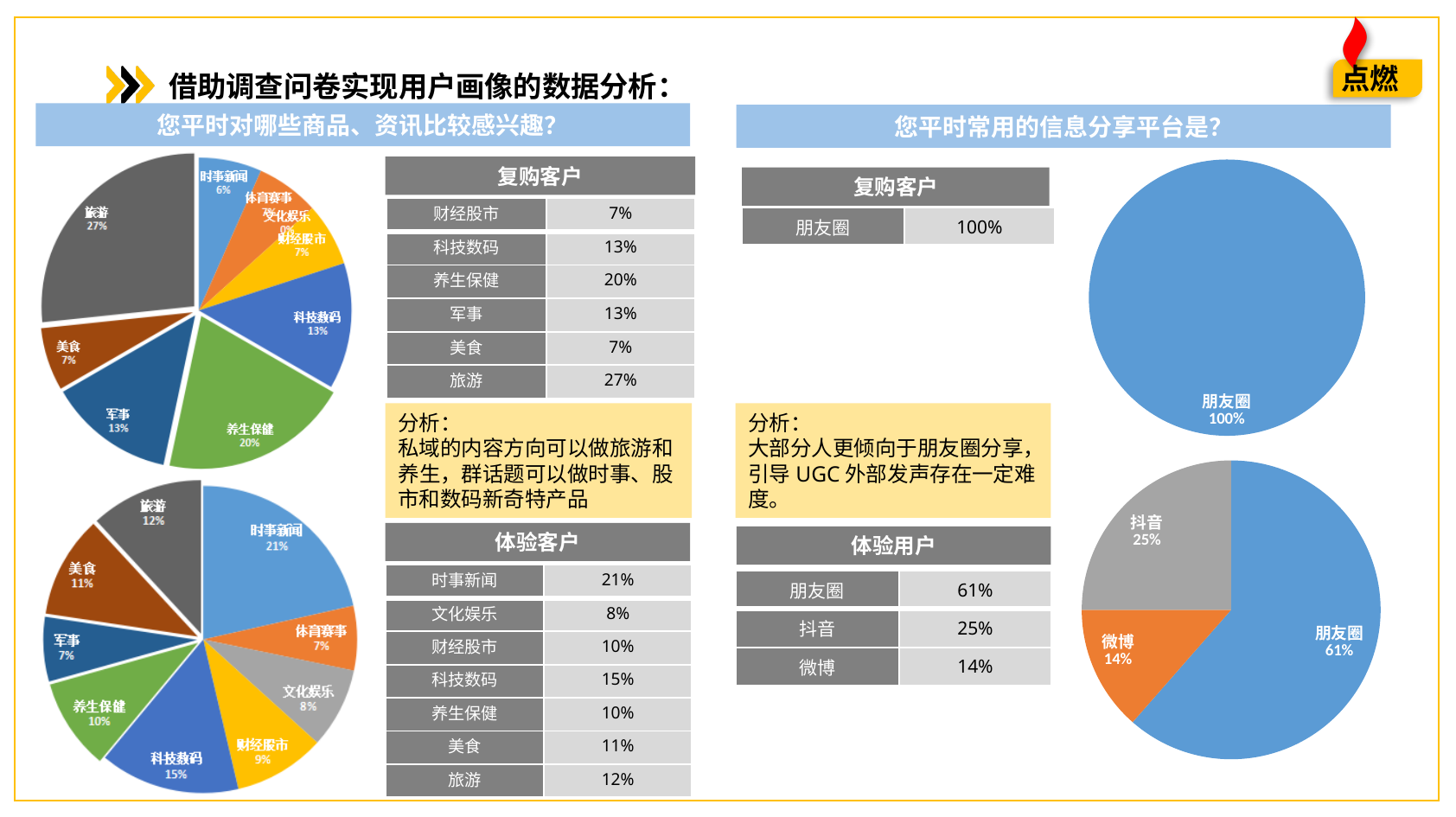
What kind of chart is used in the top-left of the slide to show 复购客户 interests? Pie chart In the bottom-right pie chart, what is the difference between the 朋友圈 share and the 抖音 share? 36% In the bottom-right pie chart (体验用户 sharing platforms), what share does 朋友圈 have? 61% In the bottom-right pie chart (体验用户 sharing platforms), what share does 抖音 have? 25% In the top-left pie chart (复购客户 interests), which category has the largest slice? 旅游 In the top-left pie chart (复购客户 interests), what share does 养生保健 have? 20% In the bottom-right pie chart (体验用户 sharing platforms), which platform has the smallest slice? 微博 In the bottom-left pie chart (体验客户 interests), which is larger, the 美食 slice or the 军事 slice? 美食 In the top-right pie chart (复购客户 sharing platforms), what share does 朋友圈 have? 100% In the bottom-left pie chart (体验客户 interests), which category has the largest slice? 时事新闻 In the bottom-left pie chart (体验客户 interests), what share does 科技数码 have? 15% In the bottom-right pie chart (体验用户 sharing platforms), how many slices are there? 3